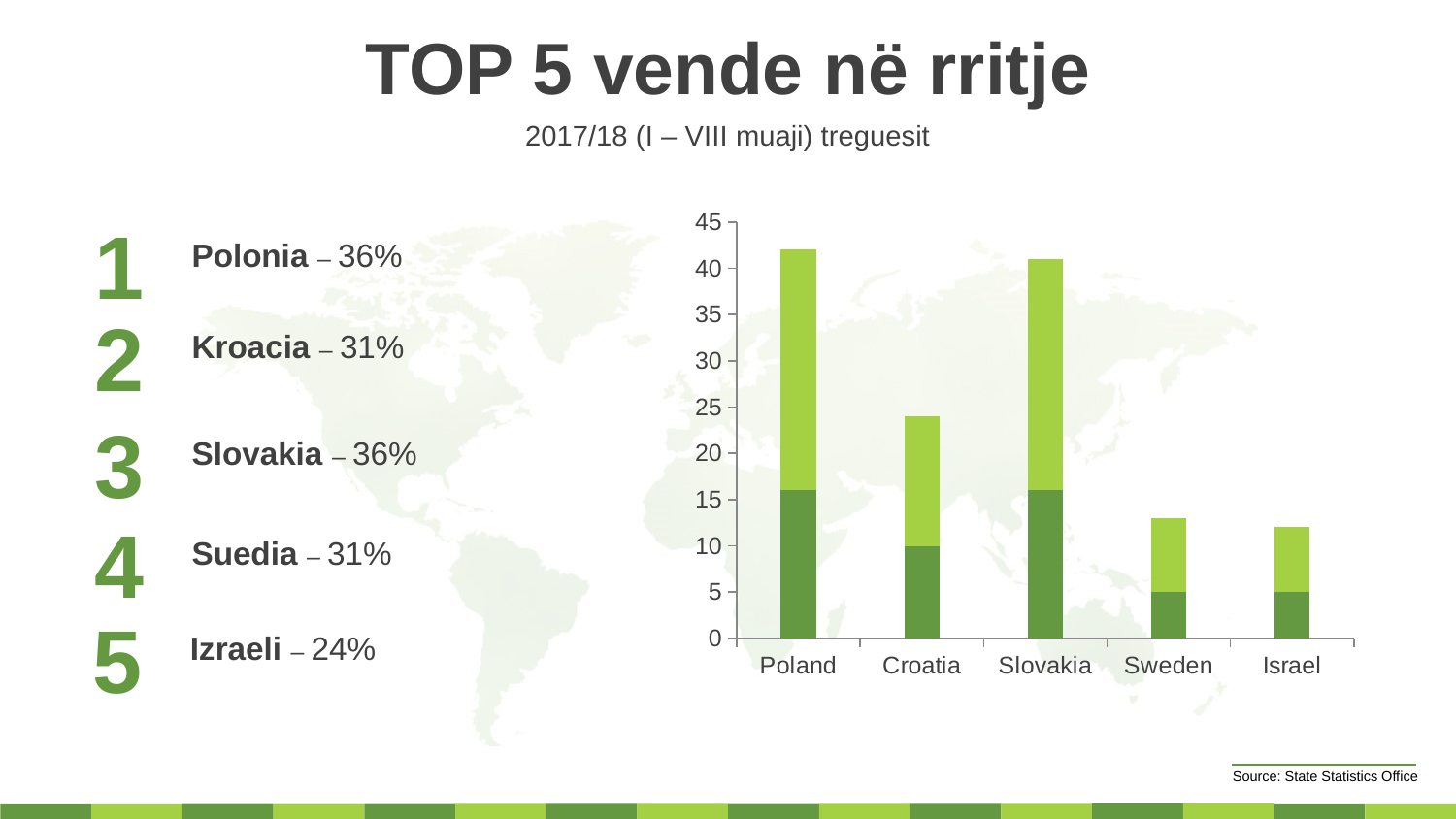
Is the total bar for Poland greater or less than 40? greater Is the total bar for Slovakia greater or less than 35? greater Which has the taller total bar, Poland or Croatia? Poland Is the total bar for Israel greater or less than 10? greater What is the value of the dark green bottom segment of the Croatia bar? 10 Which has the taller total bar, Slovakia or Sweden? Slovakia What kind of chart is shown on the slide? stacked bar chart How many countries are shown on the x axis of the chart? 5 How many coloured segments does each bar in the chart have? 2